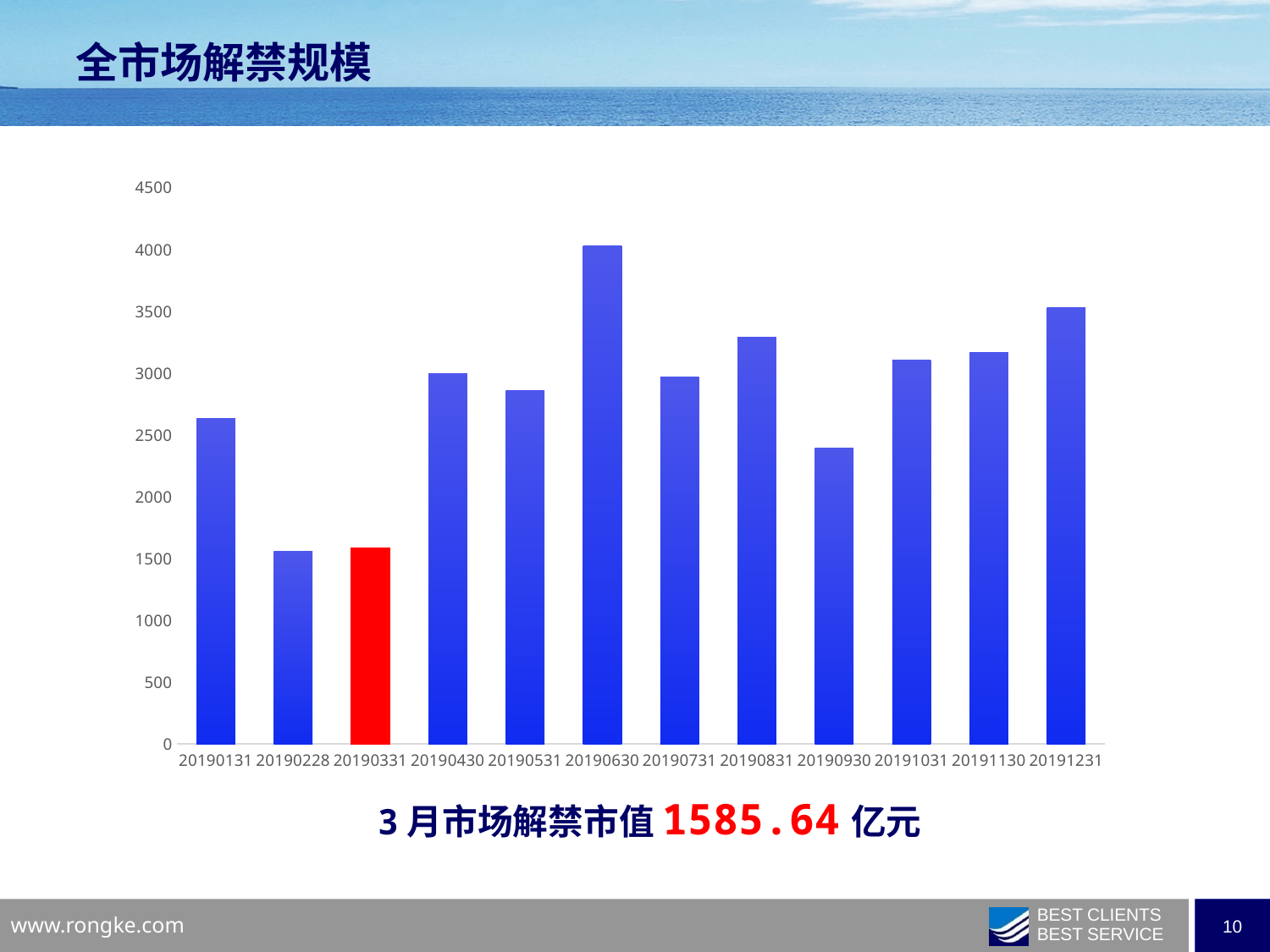
Is the value for 20190531 greater or less than 3000? less Is the value for 20190131 greater or less than 2500? greater How many categories (months) are shown on the x axis of the chart? 12 Which is larger, the value for 20190630 or the value for 20191231? 20190630 Is the value for 20190930 greater or less than 2500? less What type of chart is shown on the slide? bar chart What is the title of the chart on the slide? 全市场解禁规模 Which is larger, the value for 20190131 or the value for 20190930? 20190131 What is the value for 20190331 (the March market unlock value) as stated on the slide? 1585.64 亿元 Which category is highlighted with a red bar in the chart? 20190331 Which category has the highest bar in the chart? 20190630